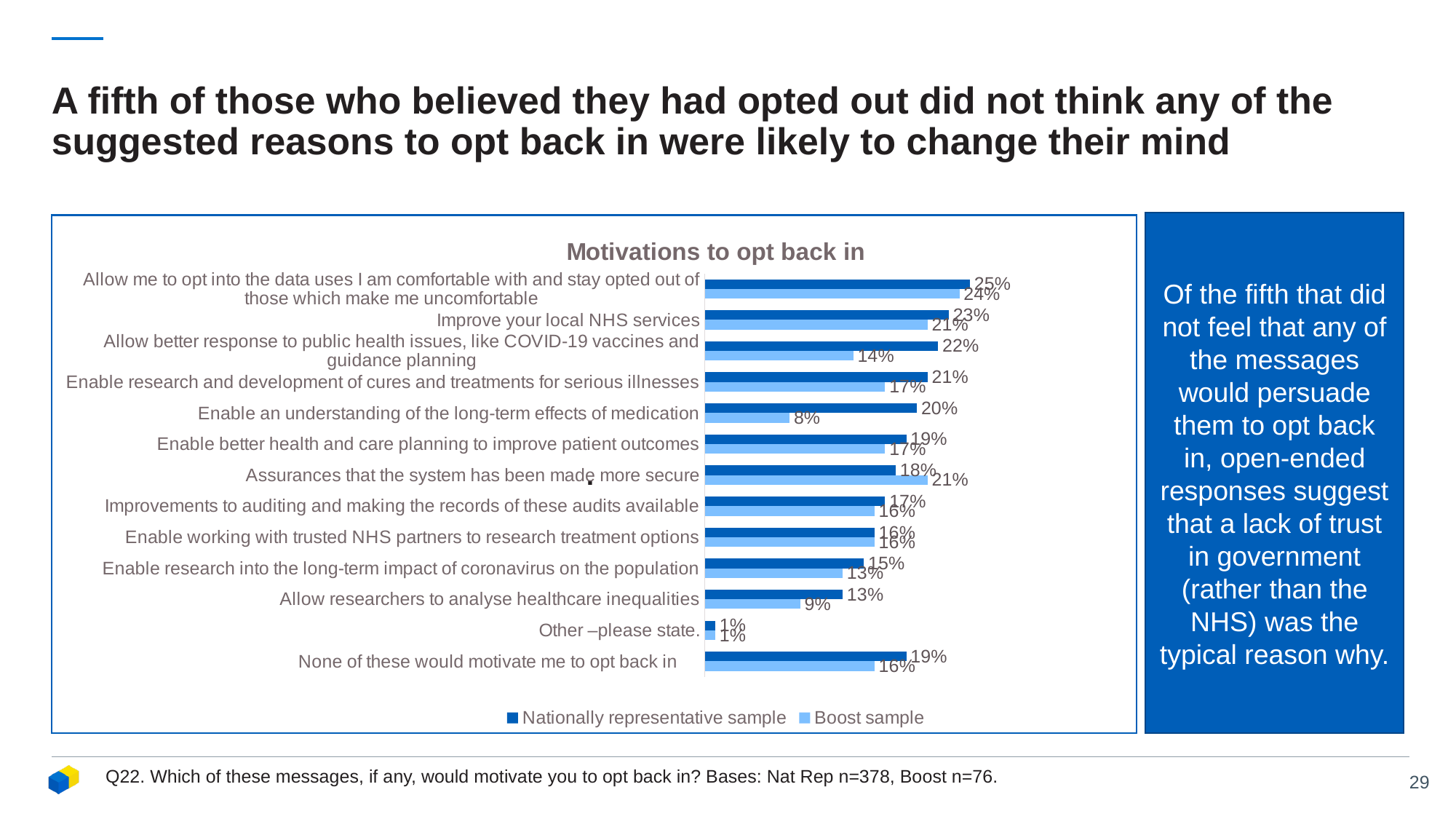
How many categories are plotted in the chart? 13 For 'Assurances that the system has been made more secure', which sample has the larger value? Boost sample How many series does the chart legend list? 2 What is the Boost sample value for 'Enable an understanding of the long-term effects of medication'? 8% What is the title of the chart? Motivations to opt back in What is the difference between the Nationally representative sample and Boost sample values for 'Allow researchers to analyse healthcare inequalities'? 4% Which category has the lowest Boost sample value? Other –please state. What type of chart is shown on the slide? Bar chart What is the Boost sample value for 'Allow better response to public health issues, like COVID-19 vaccines and guidance planning'? 14% What is the Nationally representative sample value for 'None of these would motivate me to opt back in'? 19% Which category has the highest Nationally representative sample value? Allow me to opt into the data uses I am comfortable with and stay opted out of those which make me uncomfortable What is the Nationally representative sample value for 'Enable an understanding of the long-term effects of medication'? 20%